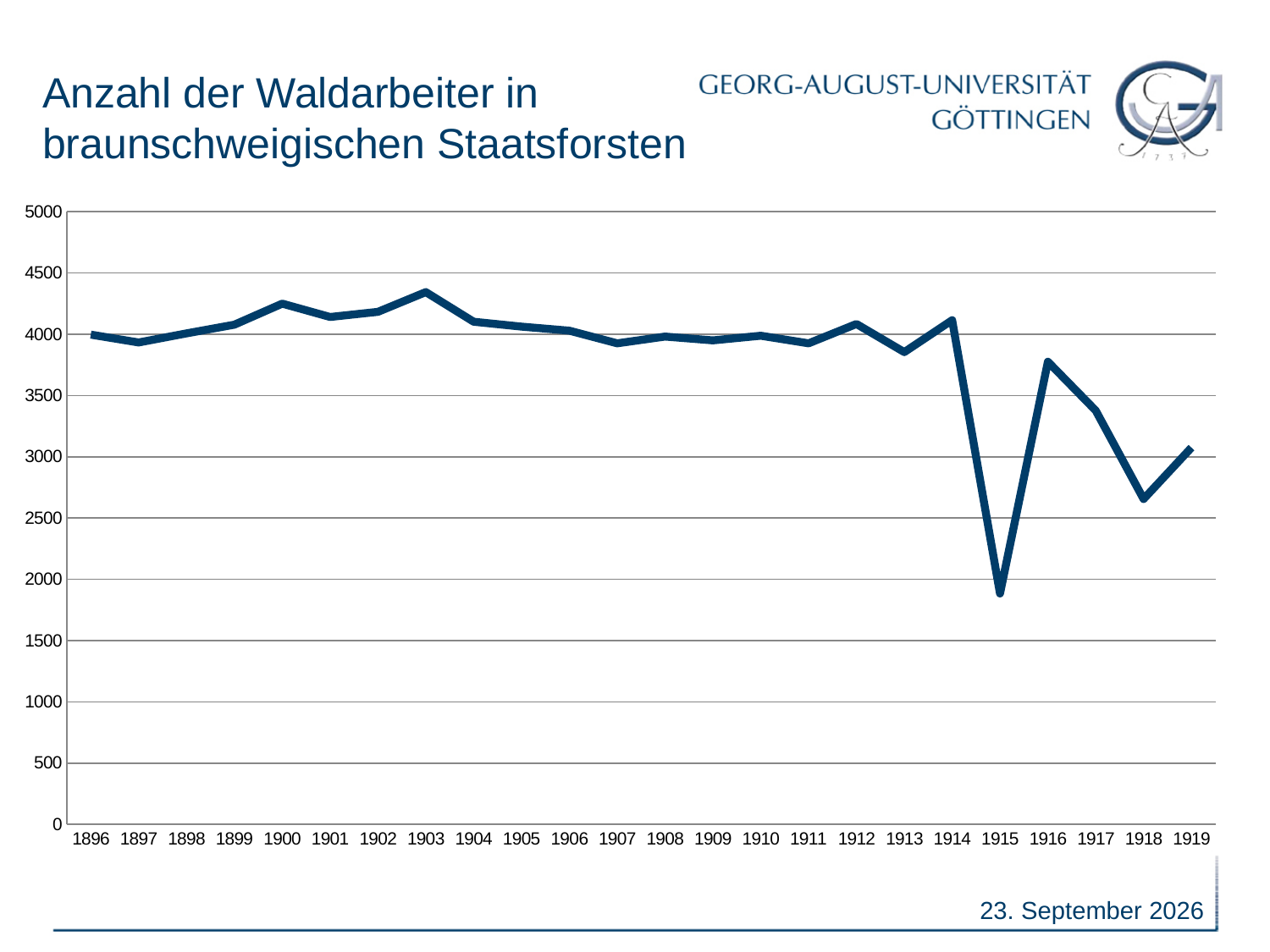
Is the value for 1915 greater or less than 2000? less Which year has the larger value, 1914 or 1915? 1914 What kind of chart is shown on the slide? line chart Which year has the lowest number of forest workers? 1915 How many years are plotted along the x axis? 24 Is the value for 1918 greater or less than 2500? greater Which year has the highest number of forest workers? 1903 What is the title of the slide? Anzahl der Waldarbeiter in braunschweigischen Staatsforsten Is the value for 1916 greater or less than 3500? greater Do the values rise or fall from 1916 to 1918? fall